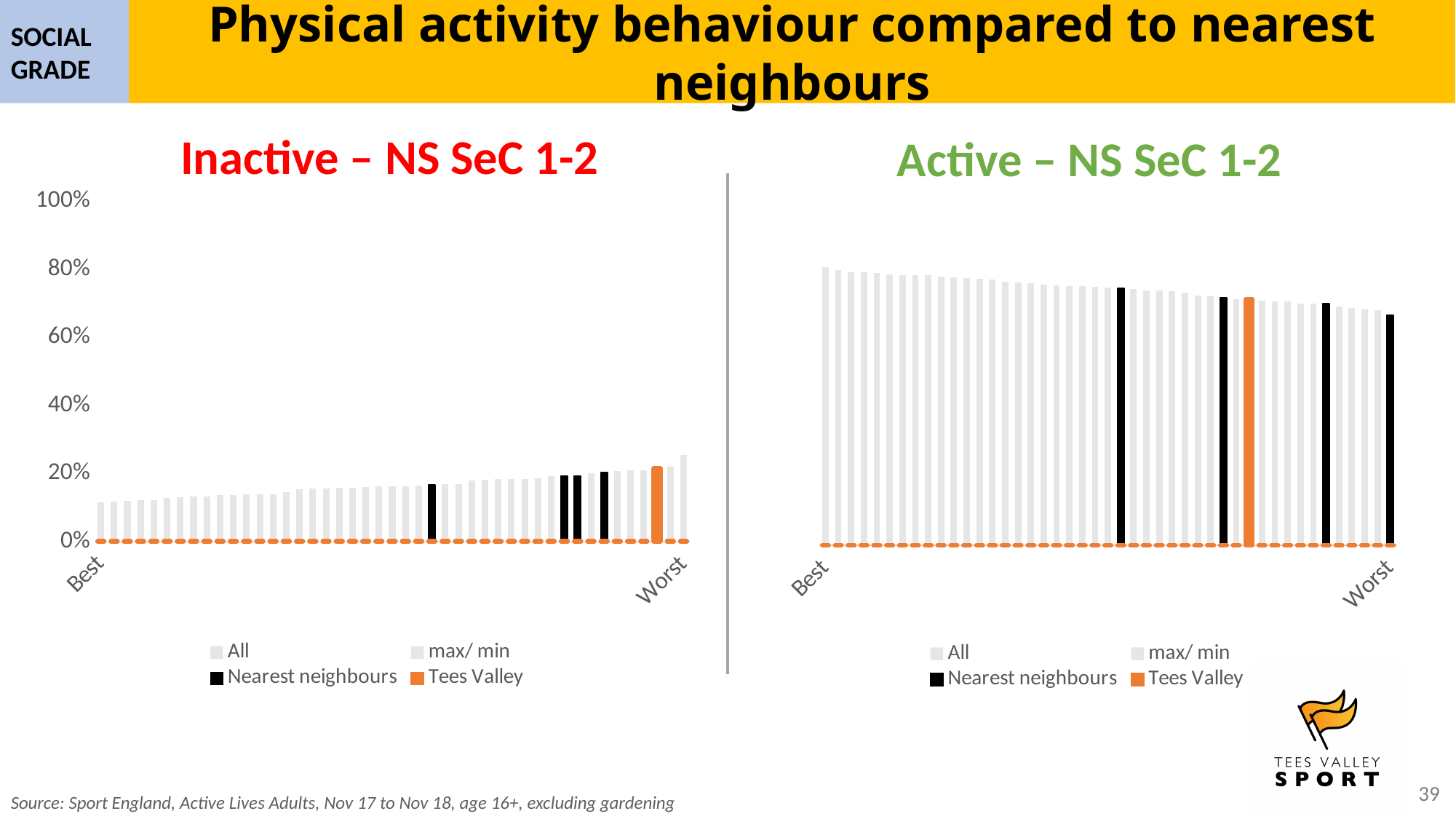
In the 'Active – NS SeC 1-2' chart, is the value for Tees Valley greater or less than 80%? less In the 'Inactive – NS SeC 1-2' chart, which is larger: the Tees Valley bar or the Worst bar? Worst How many series does the legend of the 'Active – NS SeC 1-2' chart list? 4 In the 'Active – NS SeC 1-2' chart, which is larger: the Best bar or the Tees Valley bar? Best In the 'Inactive – NS SeC 1-2' chart, is the value for Tees Valley greater or less than 40%? less In the 'Active – NS SeC 1-2' chart, do the bars rise or fall from Best to Worst? fall Is the Tees Valley value larger in the 'Active – NS SeC 1-2' chart or the 'Inactive – NS SeC 1-2' chart? Active – NS SeC 1-2 In the 'Inactive – NS SeC 1-2' chart, do the bars rise or fall from Best to Worst? rise What type of chart is the 'Inactive – NS SeC 1-2' chart? bar chart What colour represents Tees Valley in the legend of the 'Inactive – NS SeC 1-2' chart? orange What are the labels at the two ends of the x axis in the 'Active – NS SeC 1-2' chart? Best and Worst In the 'Active – NS SeC 1-2' chart, is the value for Tees Valley greater or less than 60%? greater